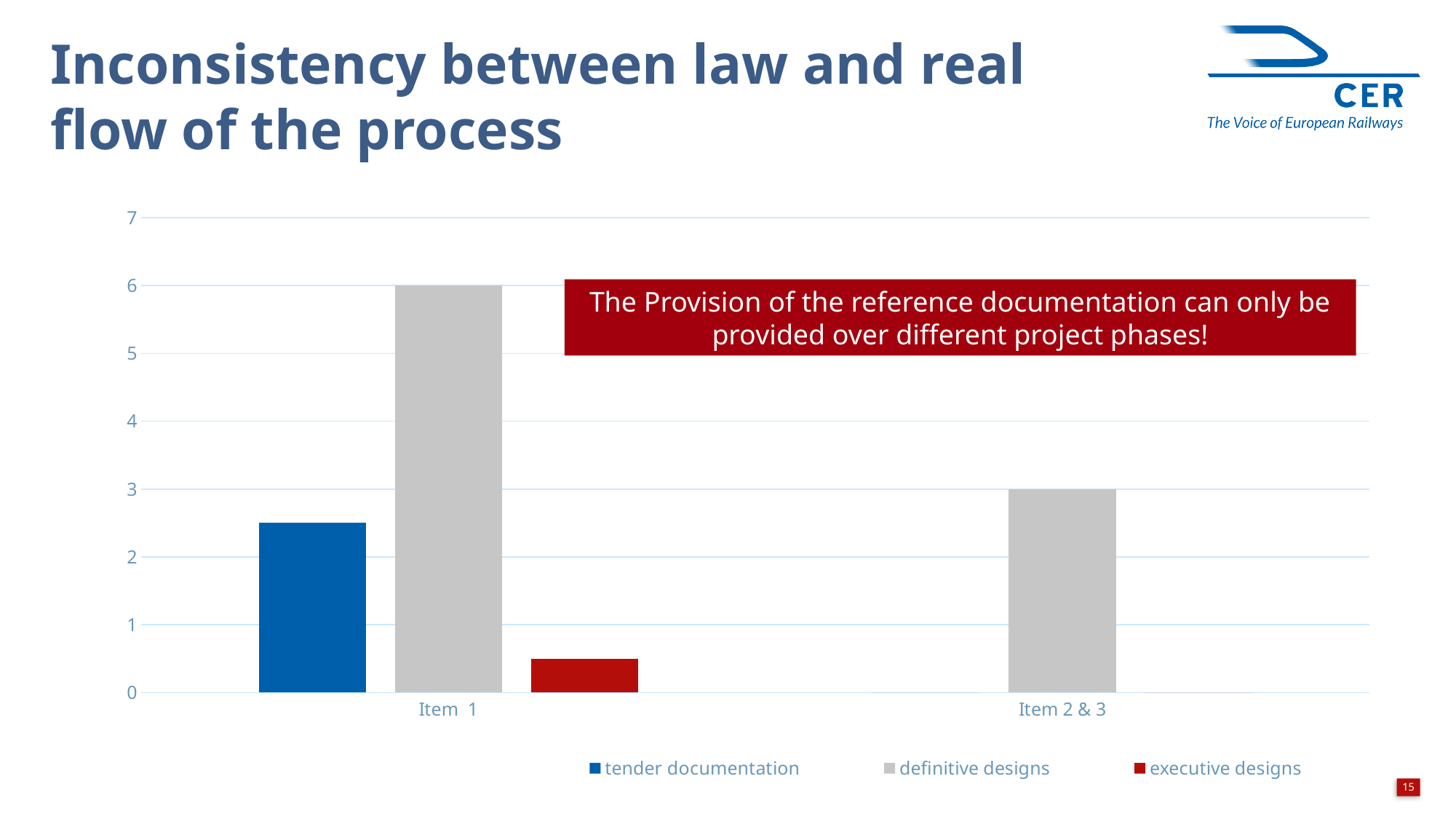
Which series has the lowest value for Item 1? executive designs How many categories are shown on the x axis? 2 How many series does the legend list? 3 Which series has the highest value for Item 1? definitive designs For Item 1, which is larger: tender documentation or executive designs? tender documentation Is the value for executive designs for Item 1 greater or less than 1? less What kind of chart is shown on the slide? bar chart Is the value for tender documentation for Item 1 greater or less than 2? greater What is the value of definitive designs for Item 1? 6 What colour are the bars for the definitive designs series? grey What is the difference between the definitive designs values for Item 1 and Item 2 & 3? 3 What is the value of definitive designs for Item 2 & 3? 3